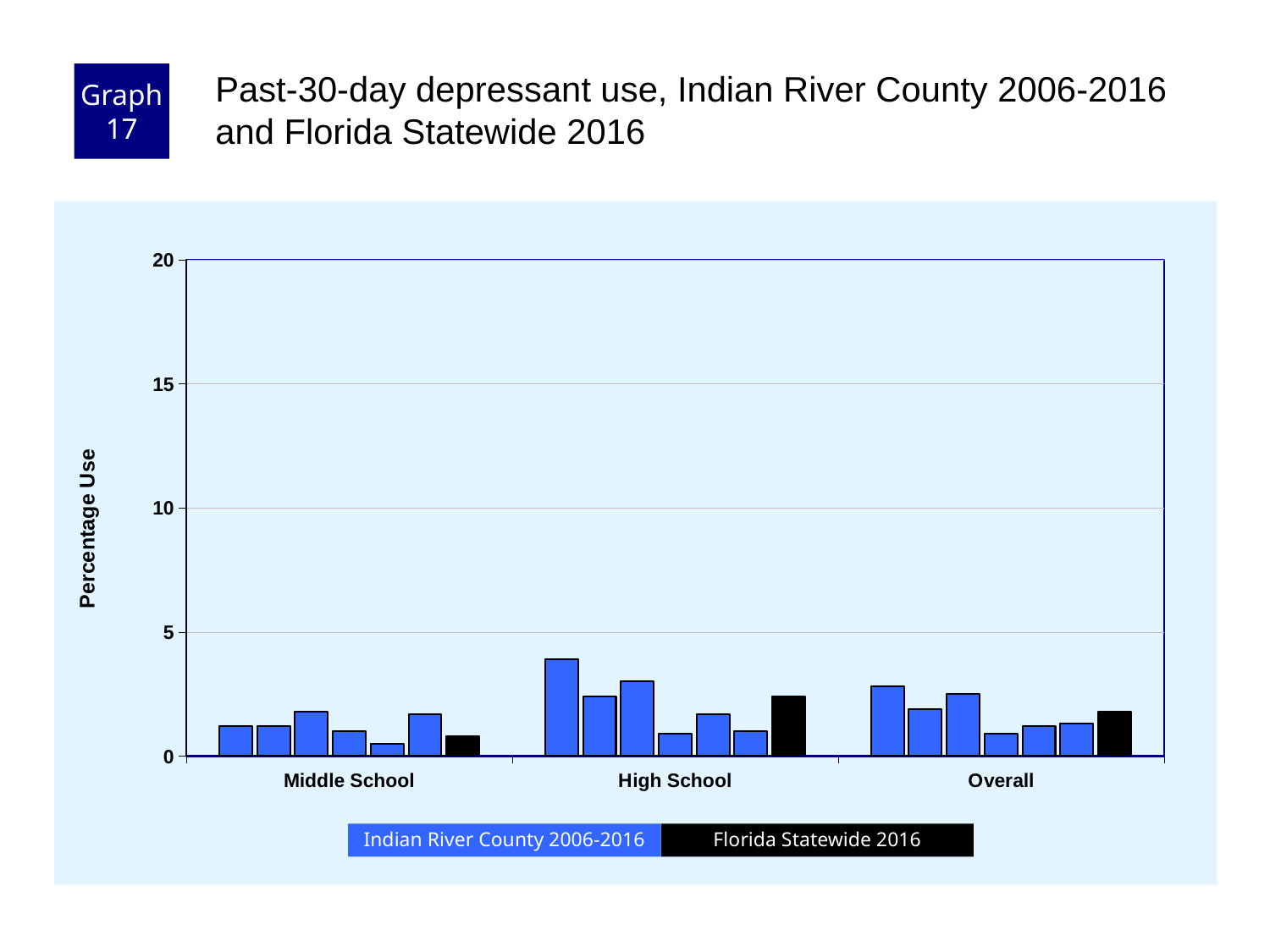
Which is larger for Florida Statewide 2016: the Middle School value or the High School value? High School What is the label of the y axis? Percentage Use Is the Florida Statewide 2016 value for High School greater or less than 5? less In which school-level group is the Florida Statewide 2016 bar the lowest? Middle School What kind of chart is shown on the slide? Bar chart Is the Florida Statewide 2016 value for Middle School greater or less than 5? less Is the tallest Indian River County bar in the High School group greater or less than 5? less How many series does the legend list? 2 Which school-level group contains the tallest bar in the chart? High School How many school-level categories are shown along the x axis? 3 Which colour represents Florida Statewide 2016 in the chart? Black Which is larger for Florida Statewide 2016: the Middle School value or the Overall value? Overall